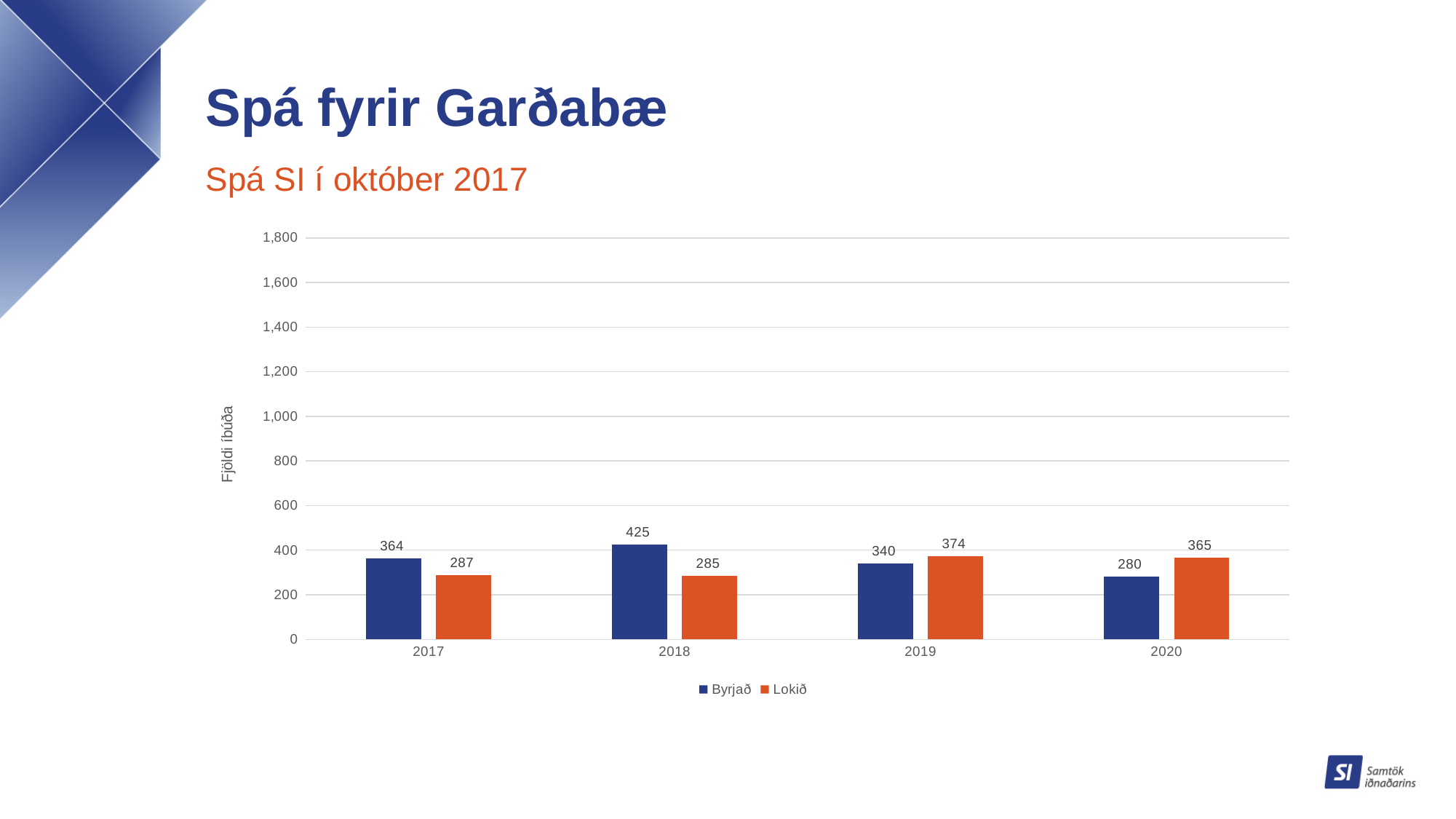
What is the value for Lokið in 2017? 287 Which is larger in 2019, Byrjað or Lokið? Lokið What is the value for Byrjað in 2018? 425 How many years are shown on the x axis? 4 What is the difference between Byrjað and Lokið in 2018? 140 What kind of chart is shown on the slide? bar chart What is the label on the vertical axis? Fjöldi íbúða Is the value for Byrjað in 2017 greater or less than 400? less In which year is the Byrjað value highest? 2018 In which year is the Byrjað value lowest? 2020 How many series does the legend list? 2 What is the value for Lokið in 2020? 365